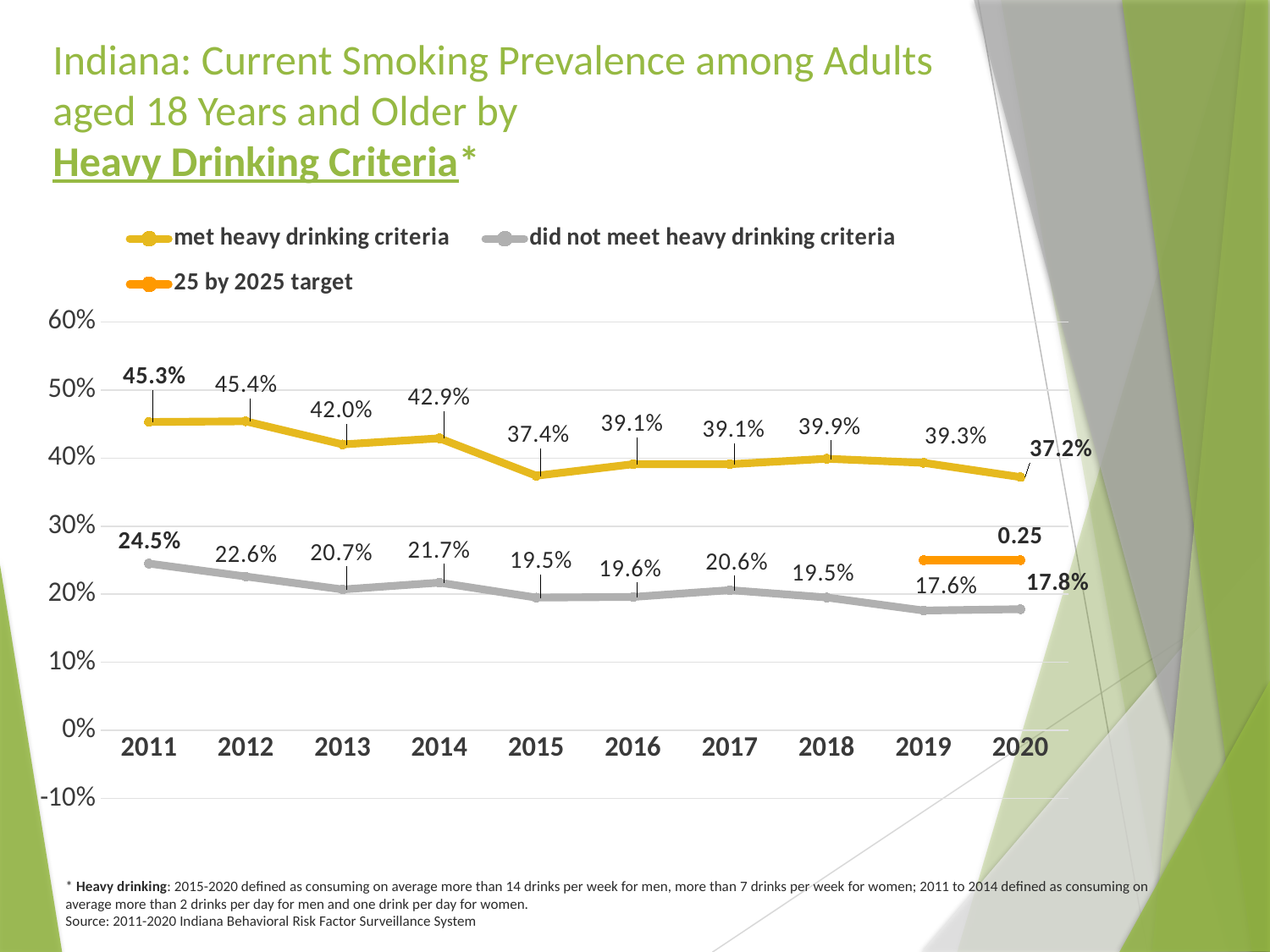
Which group had the higher smoking prevalence in 2020: those who met heavy drinking criteria or those who did not? met heavy drinking criteria What value is shown for the 25 by 2025 target? 0.25 How many years are shown on the x axis of the chart? 10 What was the smoking prevalence in 2018 for adults who did not meet heavy drinking criteria? 19.5% Overall, does smoking prevalence for adults who met heavy drinking criteria rise or fall from 2011 to 2020? fall In which year was smoking prevalence highest for adults who met heavy drinking criteria? 2012 In which year was smoking prevalence lowest for adults who did not meet heavy drinking criteria? 2019 What is the difference in 2011 between the smoking prevalence of adults who met heavy drinking criteria and those who did not? 20.8 percentage points In which year was smoking prevalence highest for adults who did not meet heavy drinking criteria? 2011 What kind of chart is shown on the slide? line chart How many series does the chart legend list? 3 What was the smoking prevalence in 2015 for adults who met heavy drinking criteria? 37.4%